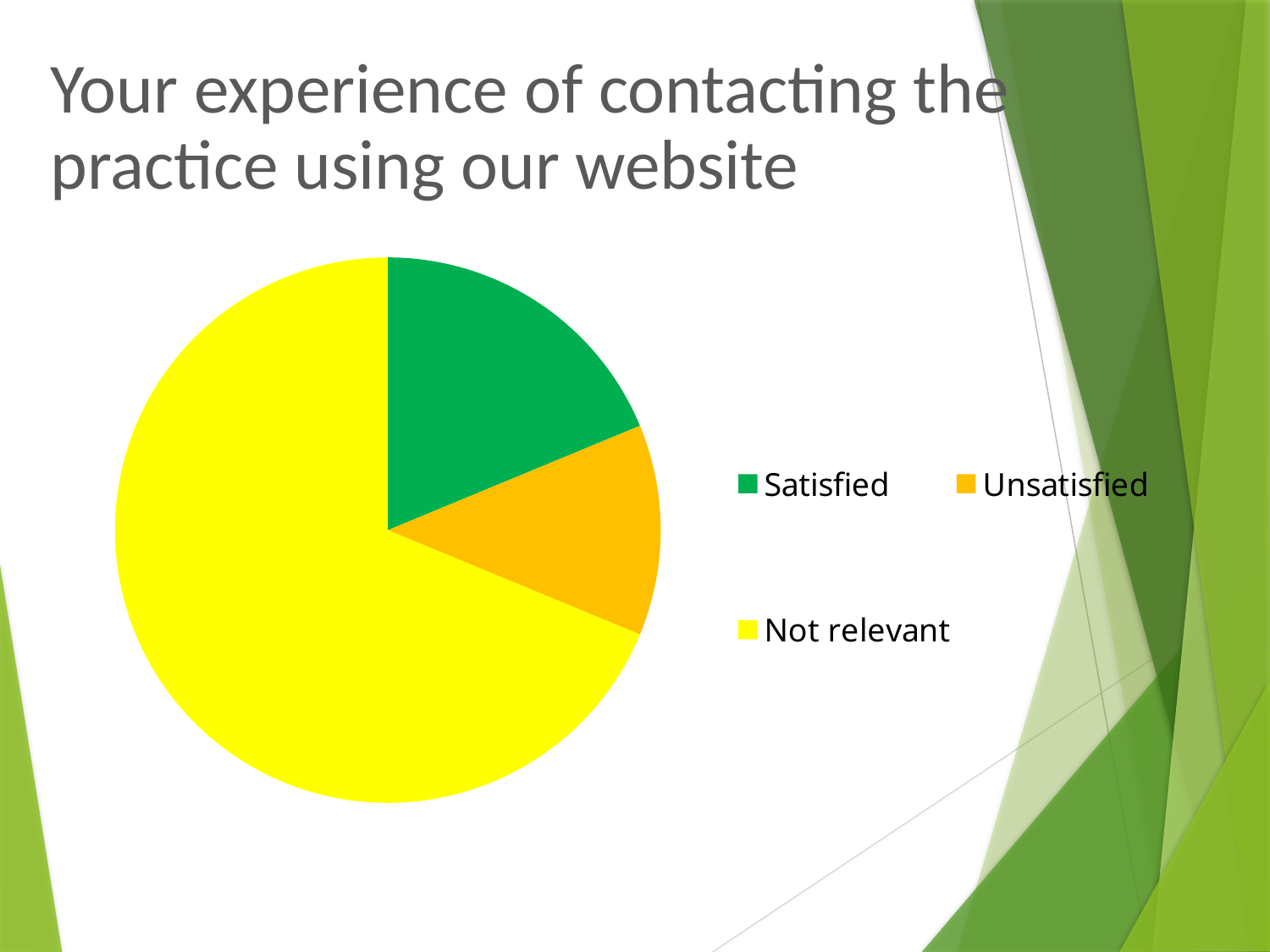
Which category has the largest slice of the pie chart? Not relevant Which slice is larger, Satisfied or Unsatisfied? Satisfied What colour is the Not relevant slice in the pie chart? Yellow What is the title of the slide containing the pie chart? Your experience of contacting the practice using our website Which slice is larger, Not relevant or Satisfied? Not relevant How many slices does the pie chart have? 3 Which category has the smallest slice of the pie chart? Unsatisfied What kind of chart is shown on the slide? Pie chart How many entries does the legend of the pie chart list? 3